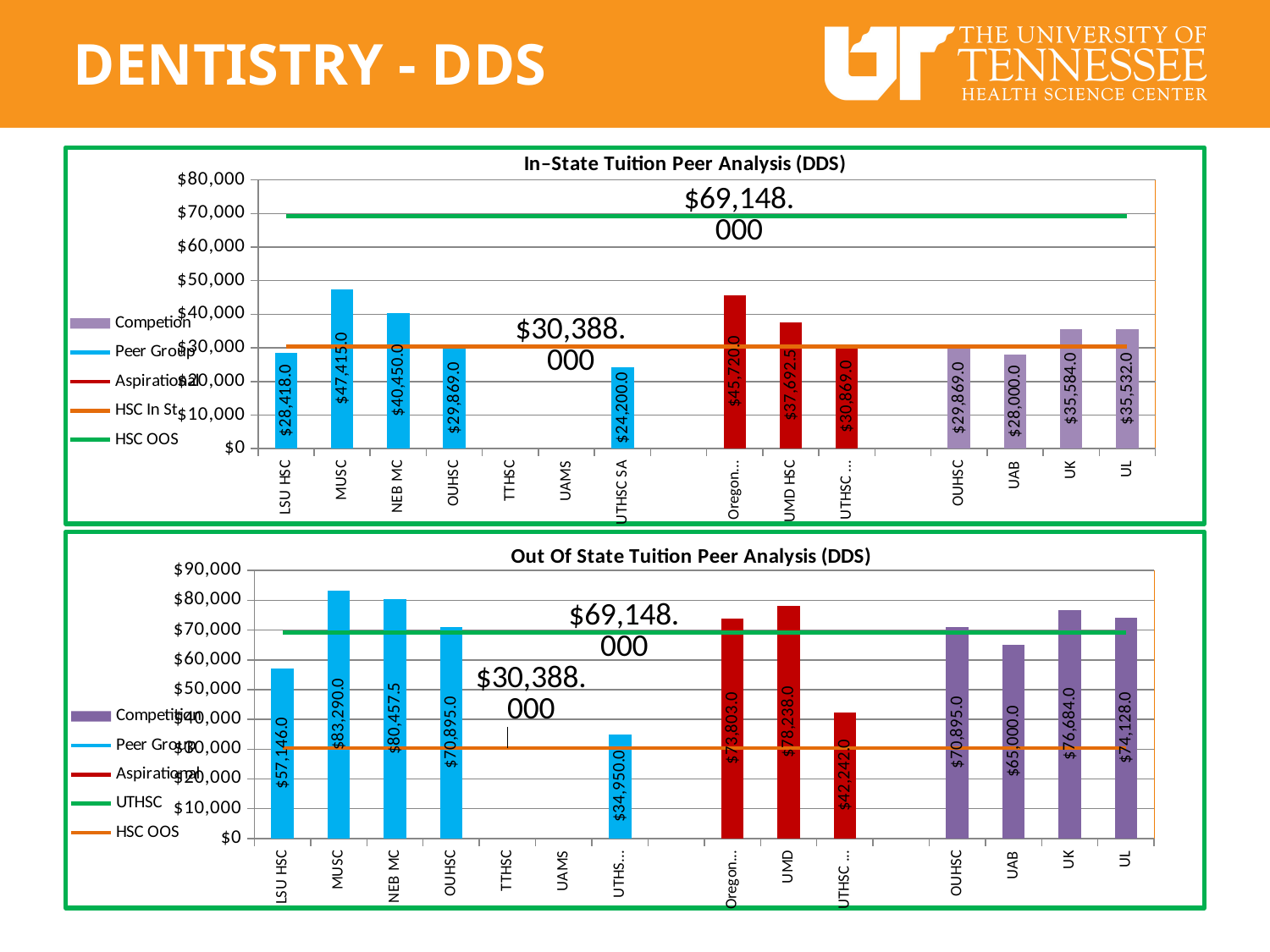
In the Out Of State Tuition Peer Analysis (DDS) chart, what is the difference between the values for UK and UL? $2,556.0 In the Out Of State Tuition Peer Analysis (DDS) chart, is the value for UAB greater or less than $60,000? greater In the Out Of State Tuition Peer Analysis (DDS) chart, what is the value for MUSC? $83,290.0 In the In-State Tuition Peer Analysis (DDS) chart, which is larger, the value for NEB MC or the value for UMD HSC? NEB MC What kind of chart is the Out Of State Tuition Peer Analysis (DDS) chart? bar chart In the Out Of State Tuition Peer Analysis (DDS) chart, what is the value for UAB? $65,000.0 How many entries does the legend of the In-State Tuition Peer Analysis (DDS) chart list? 5 In the In-State Tuition Peer Analysis (DDS) chart, which category has the highest bar? MUSC In the In-State Tuition Peer Analysis (DDS) chart, what value is shown for the green HSC OOS line? $69,148.000 In the In-State Tuition Peer Analysis (DDS) chart, what is the value for MUSC? $47,415.0 In the Out Of State Tuition Peer Analysis (DDS) chart, what is the value of the lowest labeled bar? $34,950.0 In the In-State Tuition Peer Analysis (DDS) chart, what is the value for UTHSC SA? $24,200.0